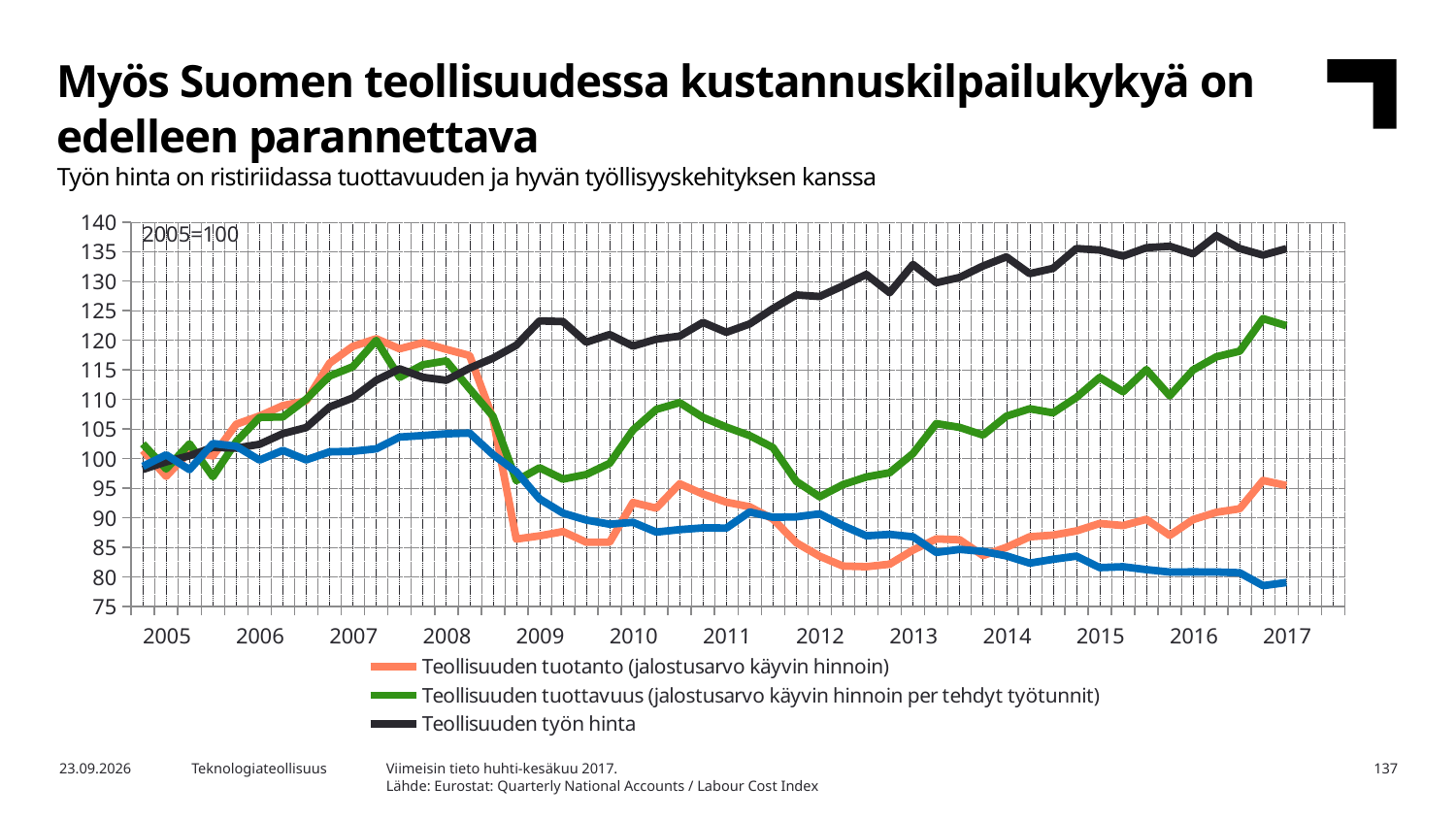
Is the value of Teollisuuden tuottavuus in 2017 greater or less than 120? greater Is the value of Teollisuuden tuotanto in 2012 greater or less than 90? less Does the Teollisuuden tuotanto line rise or fall overall from 2005 to 2017? fall What base year and index value is noted in the top-left corner of the chart? 2005=100 Is the value of Teollisuuden tuottavuus in 2012 greater or less than 100? less Which series in the legend reaches the highest value on the chart? Teollisuuden työn hinta In 2017, which is higher: Teollisuuden työn hinta or Teollisuuden tuotanto? Teollisuuden työn hinta Does the Teollisuuden työn hinta line rise or fall overall from 2005 to 2017? rise What kind of chart is shown on the slide? line chart How many year labels are shown on the x axis? 13 How many series does the chart legend list? 3